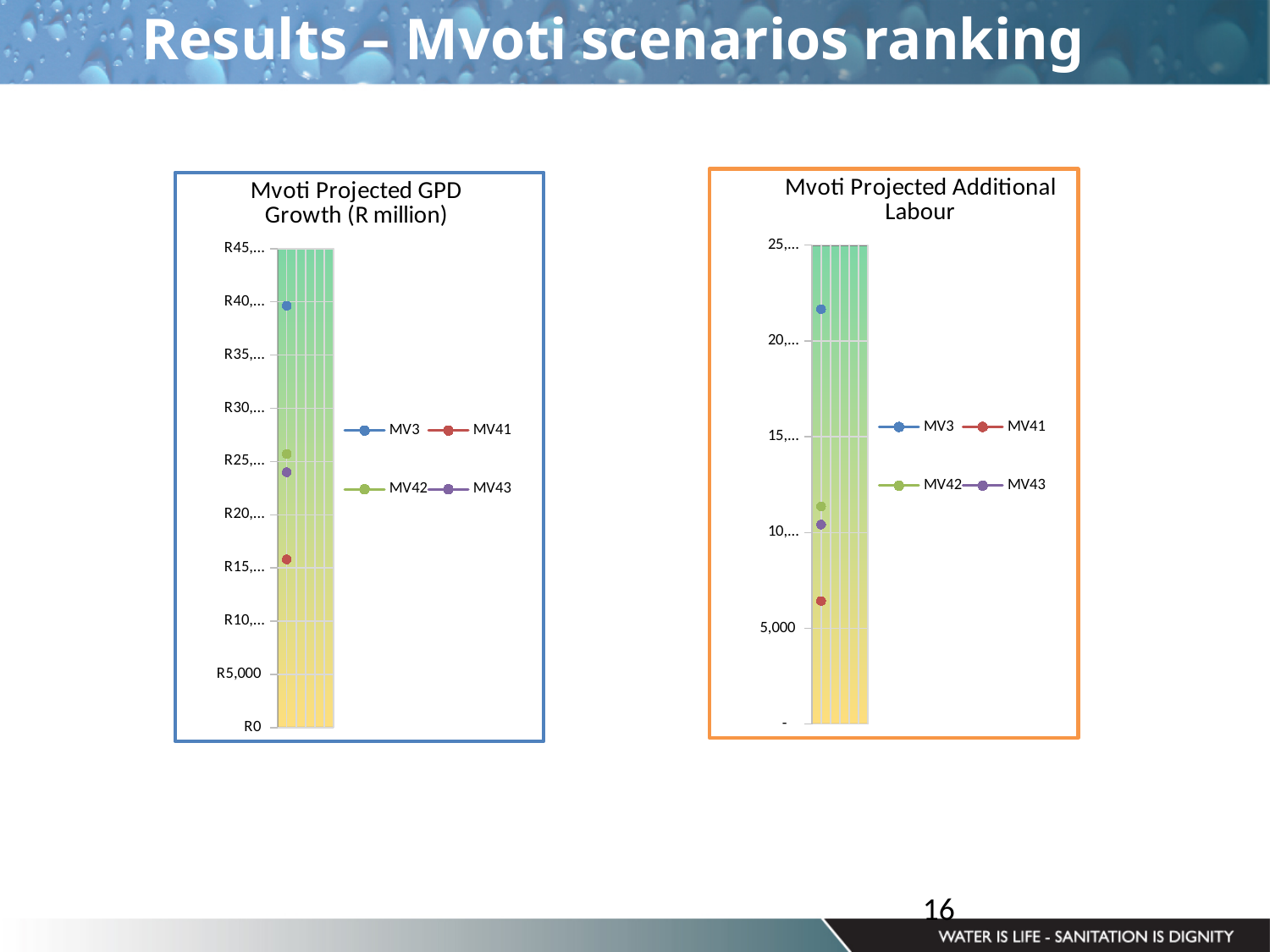
How many series does the legend of the Mvoti Projected GPD Growth (R million) chart list? 4 In the Mvoti Projected Additional Labour chart, which scenario has the lowest value? MV41 In the Mvoti Projected GPD Growth (R million) chart, which is larger, the value for MV3 or the value for MV41? MV3 In the Mvoti Projected GPD Growth (R million) chart, which scenario has the highest value? MV3 How many series does the legend of the Mvoti Projected Additional Labour chart list? 4 In the Mvoti Projected Additional Labour chart, which scenario has the highest value? MV3 In the Mvoti Projected Additional Labour chart, is the value for MV41 greater or less than 5,000? greater In the Mvoti Projected Additional Labour chart, which is larger, the value for MV42 or the value for MV41? MV42 In the Mvoti Projected GPD Growth (R million) chart, which scenario has the lowest value? MV41 In the Mvoti Projected GPD Growth (R million) chart, is the value for MV41 greater or less than R5,000? greater In the Mvoti Projected GPD Growth (R million) chart, what colour is the marker for MV41? Red What is the title of the chart on the right of the slide? Mvoti Projected Additional Labour